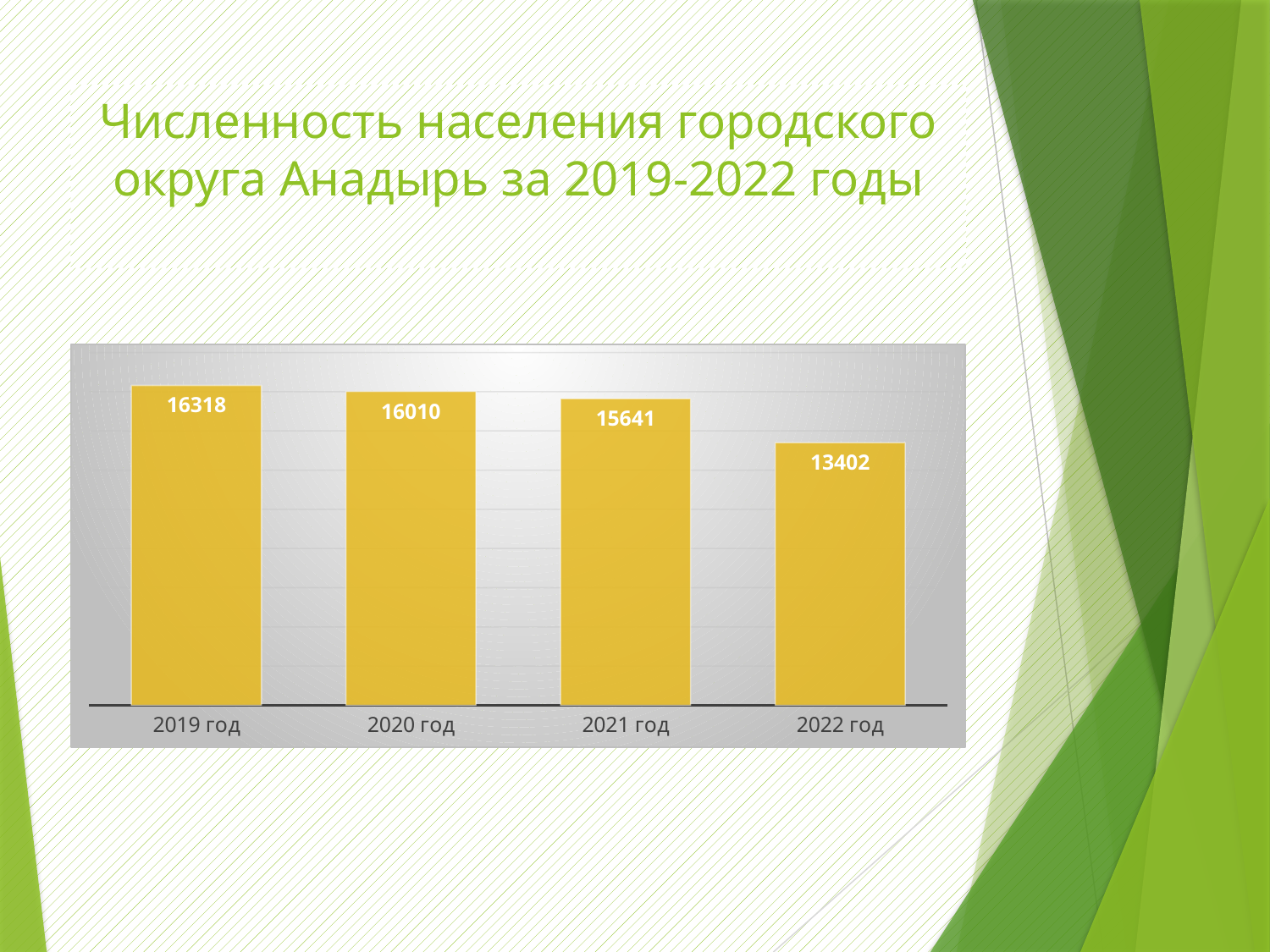
What is the population value shown for 2020 год? 16010 What is the population value shown for 2021 год? 15641 How many years (categories) are shown on the chart? 4 Do the values rise or fall from 2019 год to 2022 год? Fall What kind of chart is shown on the slide? Bar chart Which year has the lowest population value? 2022 год Which year has the highest population value? 2019 год What is the population value shown for 2022 год? 13402 What is the difference between the values for 2019 год and 2022 год? 2916 What is the population value shown for 2019 год? 16318 What is the difference between the values for 2020 год and 2021 год? 369 Which is larger, the value for 2020 год or the value for 2021 год? 2020 год